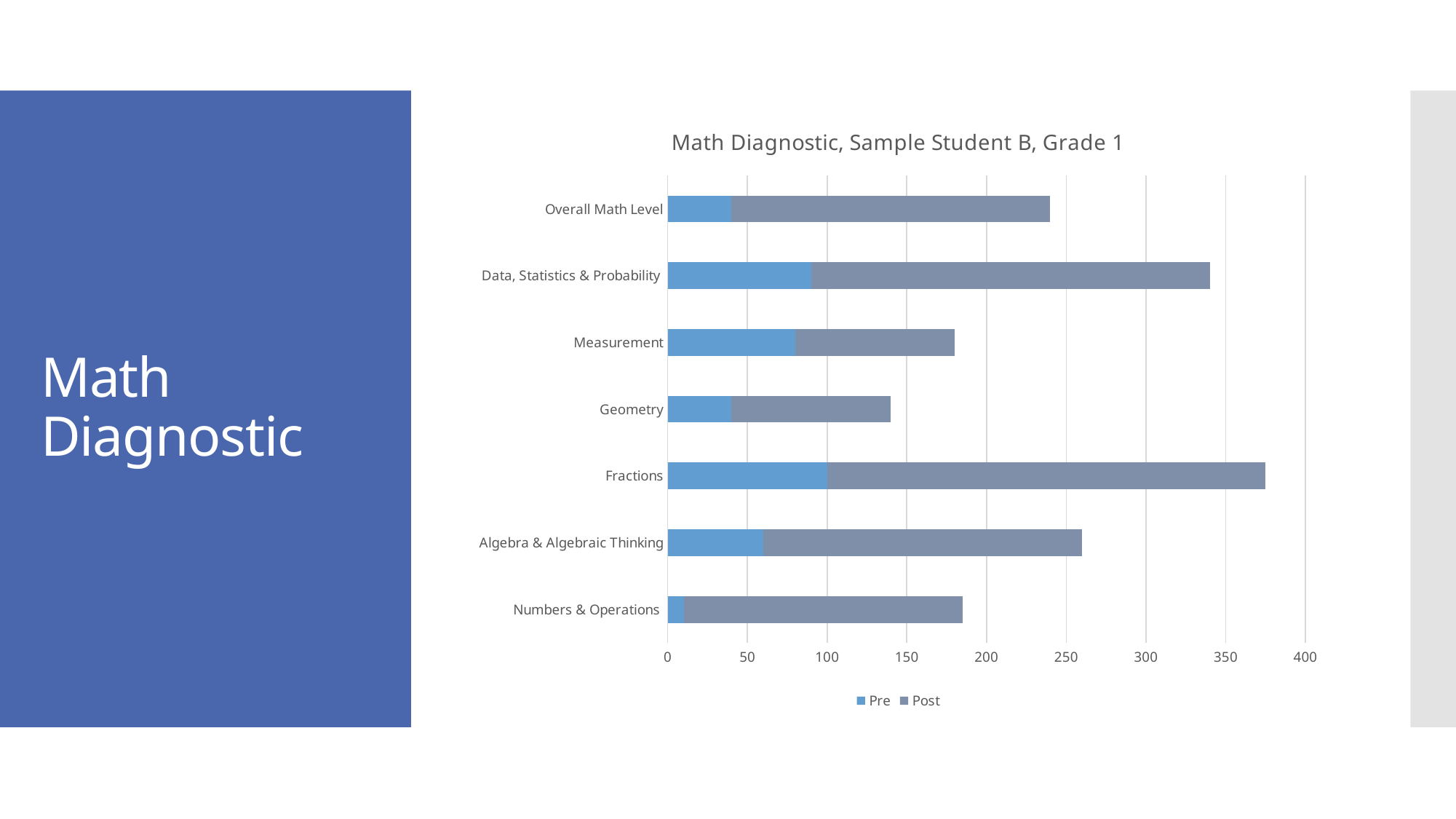
Which category has the shortest total bar? Geometry Is the Pre value for Numbers & Operations greater or less than 50? less How many series does the legend list? 2 What are the two series named in the legend? Pre and Post Is the total bar length for Geometry greater or less than 150? less Which category has the longest total bar? Fractions Is the total bar length for Fractions greater or less than 350? greater What kind of chart is shown on the slide? bar chart Which has the longer total bar, Fractions or Data, Statistics & Probability? Fractions How many categories are plotted on the chart? 7 What is the title of the chart? Math Diagnostic, Sample Student B, Grade 1 Which category has the smallest Pre value? Numbers & Operations